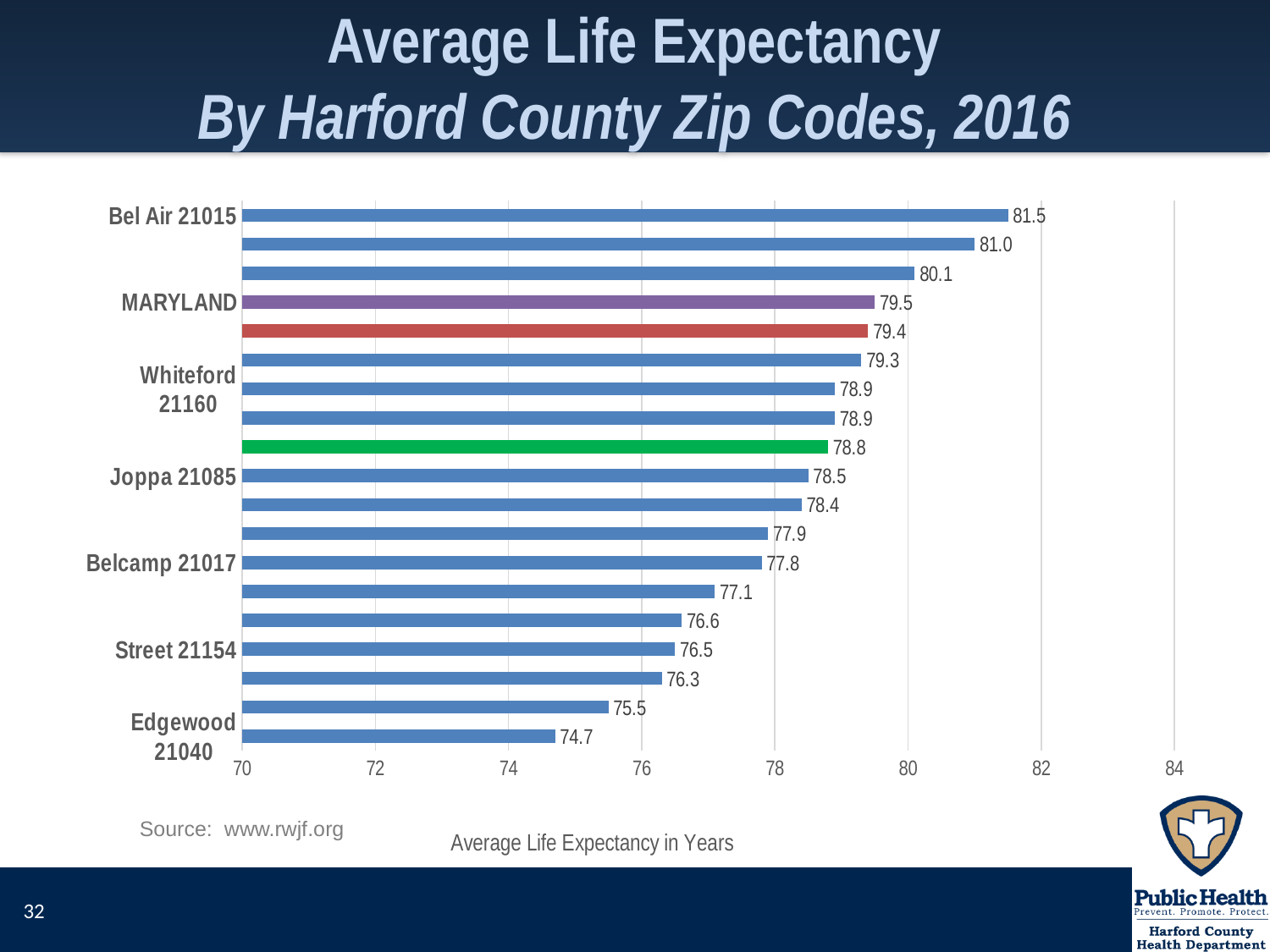
Which has a higher average life expectancy, MARYLAND or Joppa 21085? MARYLAND What is the average life expectancy shown for MARYLAND? 79.5 What kind of chart is shown on the slide? bar chart What is the average life expectancy for Belcamp 21017? 77.8 How many bars are plotted in the chart? 19 Which labeled category has the highest average life expectancy? Bel Air 21015 What is the average life expectancy for Joppa 21085? 78.5 Which labeled category has the lowest average life expectancy? Edgewood 21040 What is the average life expectancy for Bel Air 21015? 81.5 What is the difference in average life expectancy between Bel Air 21015 and Edgewood 21040? 6.8 What is the average life expectancy for Edgewood 21040? 74.7 Is the value for Street 21154 greater or less than 78? less